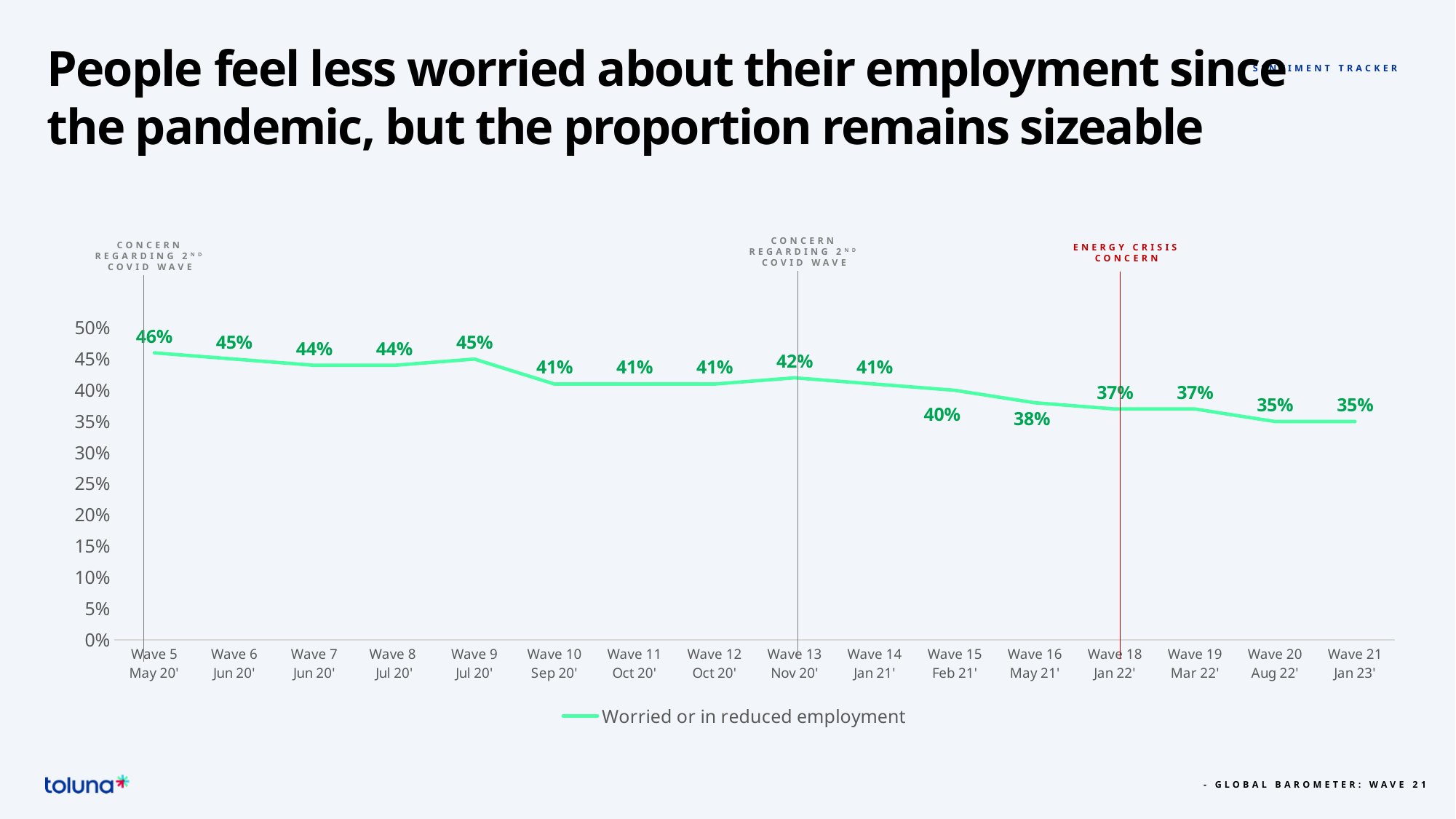
How many waves are plotted on the x axis? 16 What is the value for Wave 21 (Jan 23')? 35% What is the value for Wave 13 (Nov 20')? 42% Which wave has the highest value? Wave 5 How many series does the legend list? 1 What is the value for Wave 16 (May 21')? 38% Which is larger, the value for Wave 9 or the value for Wave 16? Wave 9 What kind of chart is shown on the slide? Line chart What is the difference between the value for Wave 5 and the value for Wave 21? 11 percentage points What is the value for Wave 5 (May 20')? 46% What is the lowest value shown on the line? 35% Do the values generally rise or fall from Wave 5 to Wave 21? Fall